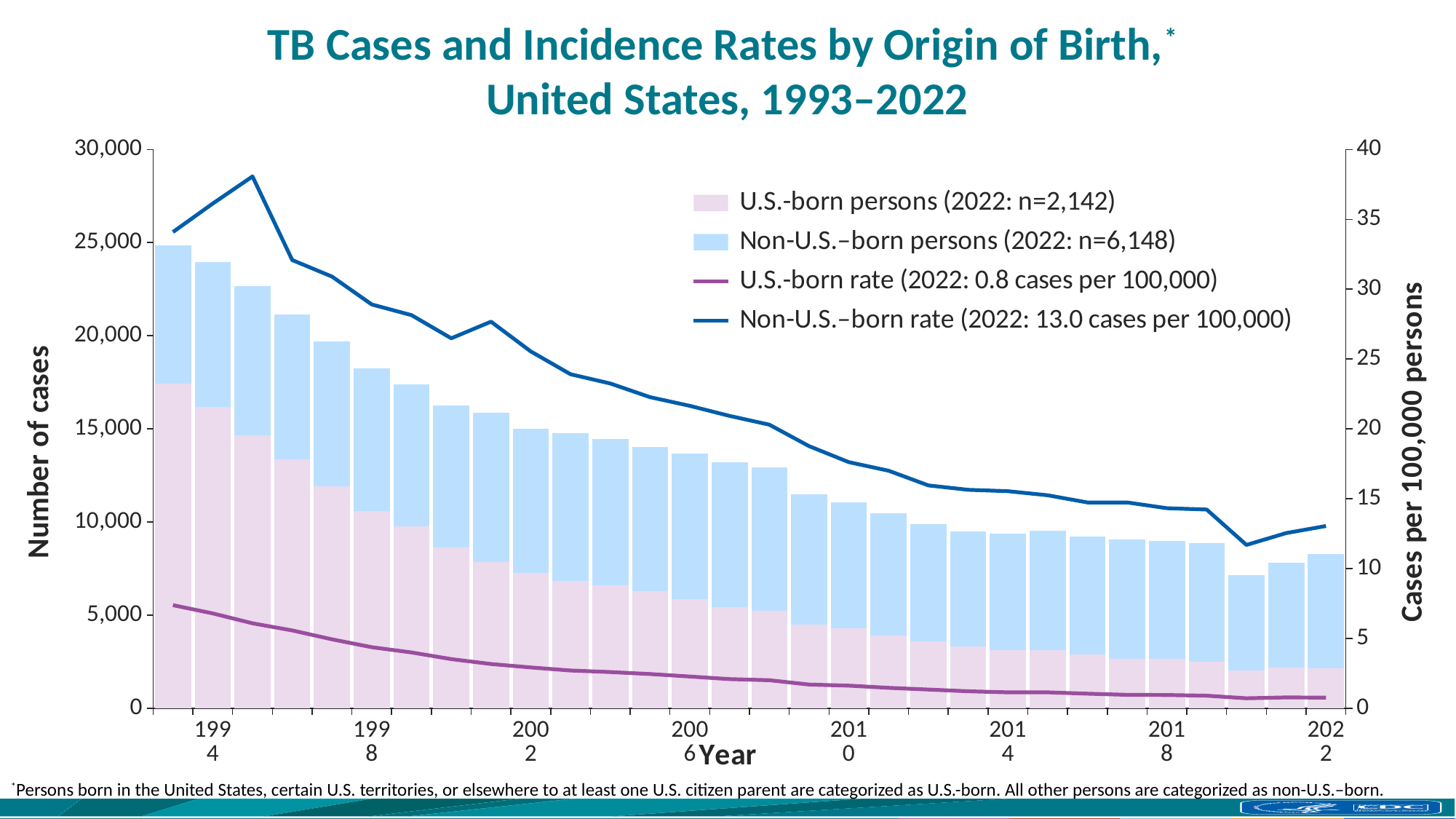
How many more TB cases were there among non-U.S.-born persons than U.S.-born persons in 2022? 4,006 How many series does the legend list? 4 What kind of chart is shown on the slide? A combined stacked bar and line chart What is the U.S.-born TB incidence rate in 2022? 0.8 cases per 100,000 What is the non-U.S.-born TB incidence rate in 2022? 13.0 cases per 100,000 In 2022, which group had more TB cases: U.S.-born persons or non-U.S.-born persons? Non-U.S.-born persons What is the number of TB cases among non-U.S.-born persons in 2022? 6,148 Is the non-U.S.-born rate in 1994 greater or less than 30 cases per 100,000? greater What is the number of TB cases among U.S.-born persons in 2022? 2,142 What is the total number of TB cases (U.S.-born plus non-U.S.-born) in 2022? 8,290 Is the total number of TB cases in 1994 greater or less than 20,000? greater Does the non-U.S.-born rate generally rise or fall from 1994 to 2022? Fall